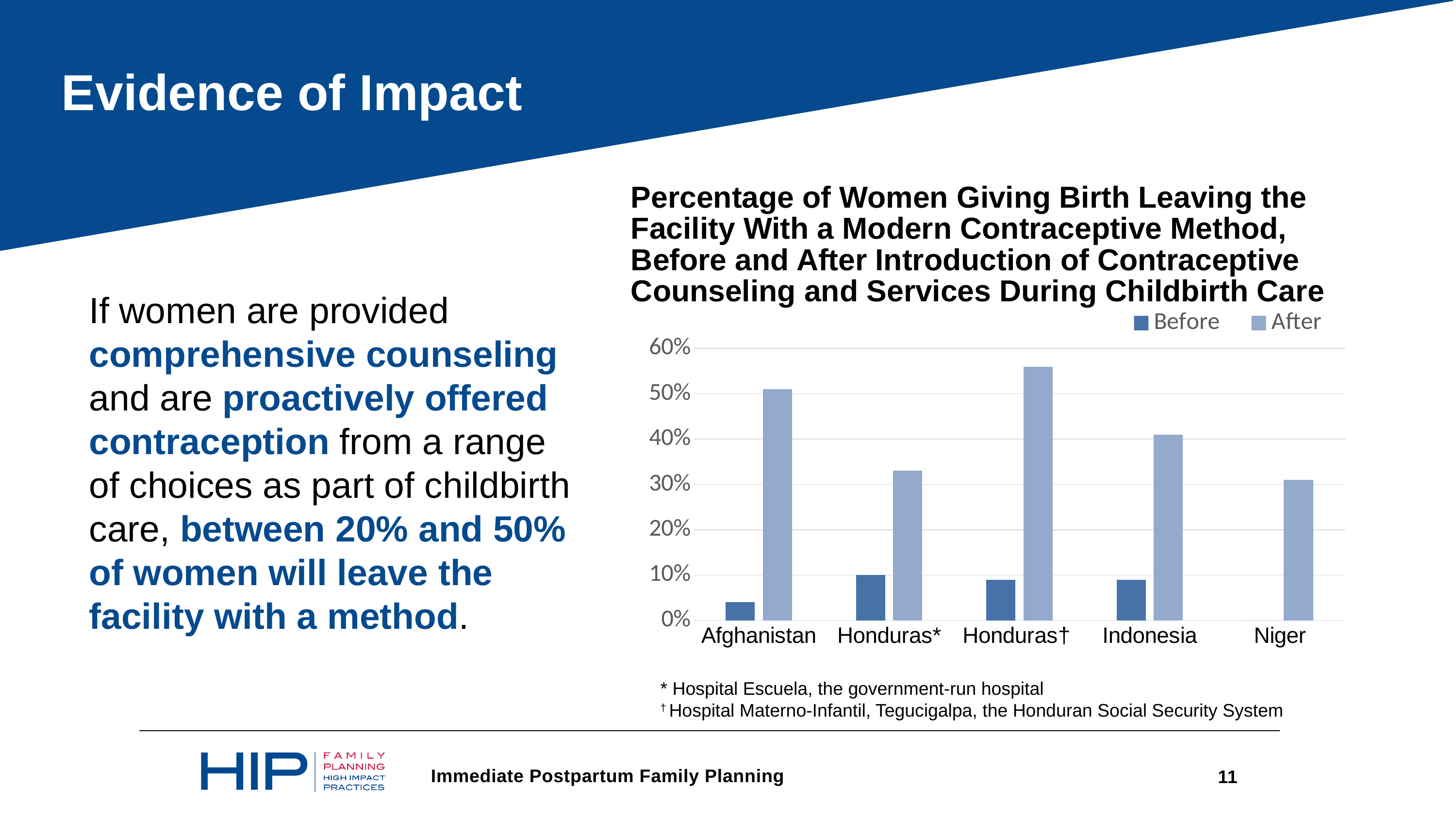
What kind of chart is shown on the slide? bar chart What are the two series named in the chart's legend? Before and After Which is larger, the After value for Honduras* or the After value for Honduras†? Honduras† Which series is shown in the darker blue colour? Before Which category has the highest After value? Honduras† Is the After value for Afghanistan greater or less than 40%? greater Which is larger, the After value for Afghanistan or the After value for Indonesia? Afghanistan Is the Before value for Afghanistan greater or less than 10%? less How many countries or facilities are shown on the x axis of the chart? 5 Is the After value for Niger greater or less than 40%? less How many series does the chart's legend list? 2